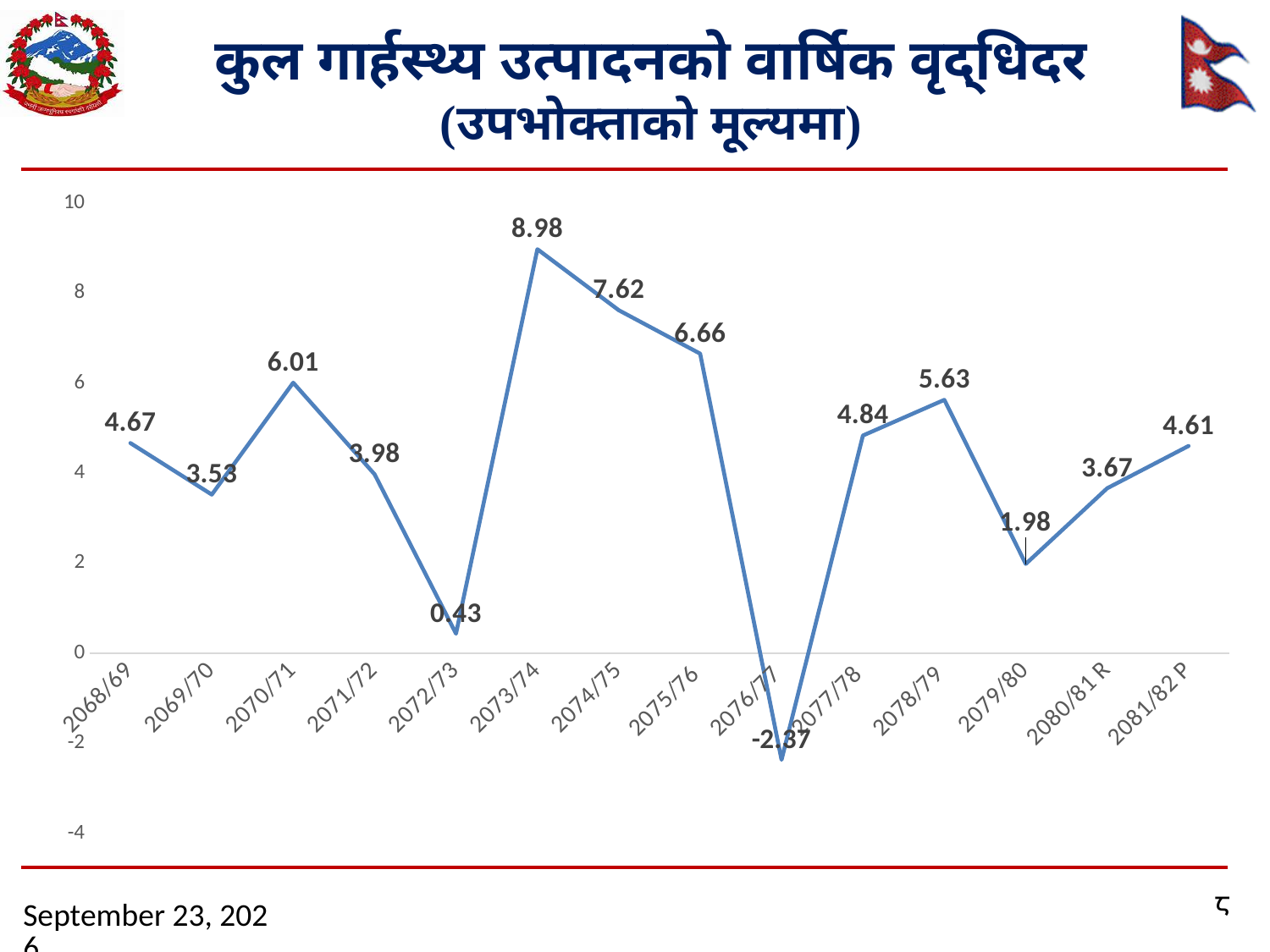
What is the value for 2072/73? 0.43 Which year has the highest value? 2073/74 What is the difference between the values for 2070/71 and 2069/70? 2.48 What type of chart is shown on the slide? line chart Which is larger, the value for 2078/79 or the value for 2077/78? 2078/79 What is the value for 2073/74? 8.98 Does the value rise or fall from 2079/80 to 2081/82 P? rise How many data points are plotted on the line? 14 What is the value for 2076/77? -2.37 What is the difference between the values for 2073/74 and 2074/75? 1.36 What is the value for 2081/82 P? 4.61 Which year has the lowest value? 2076/77